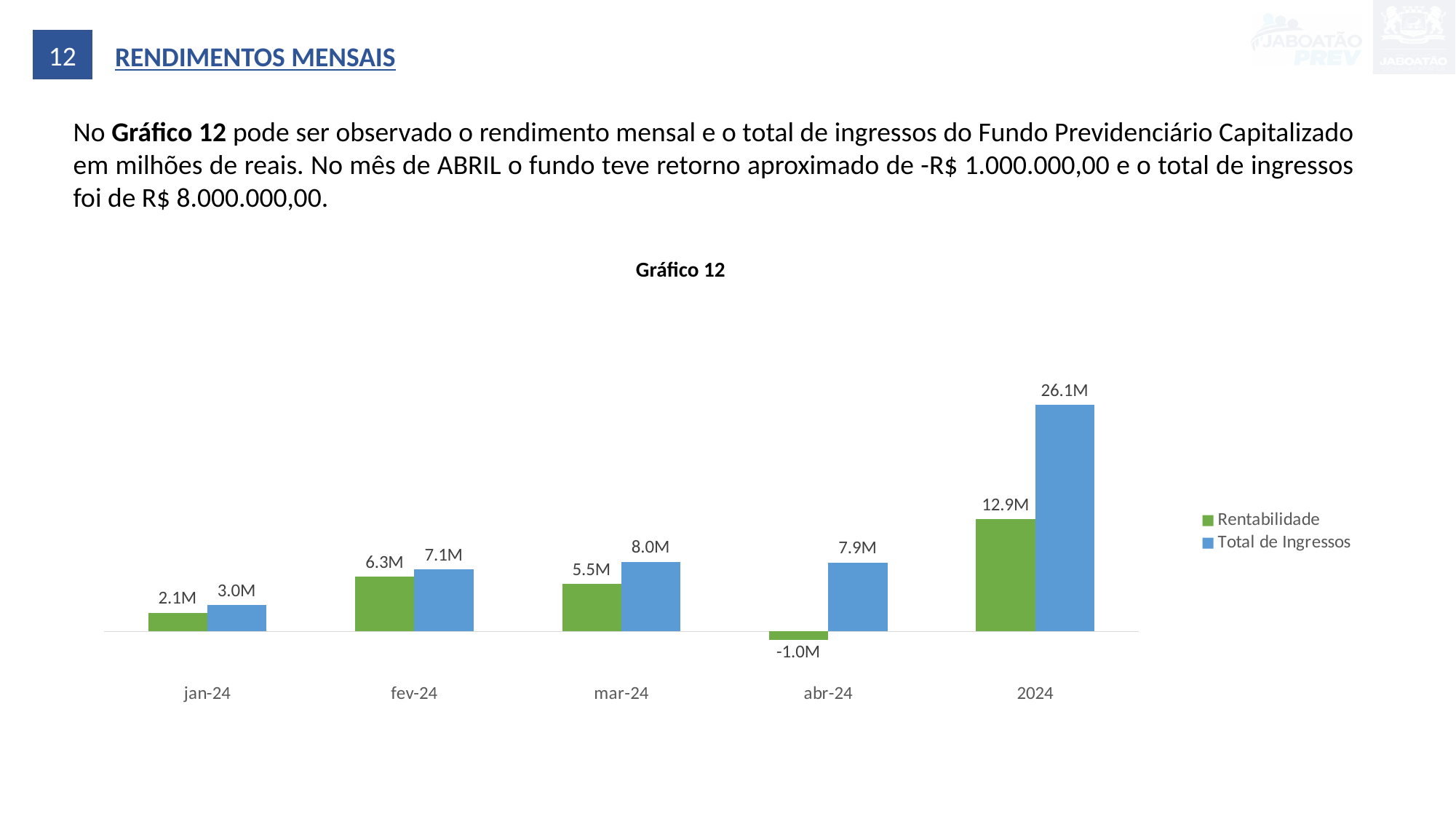
What is the difference between Total de Ingressos and Rentabilidade for 2024? 13.2M Which category has the lowest Rentabilidade value? abr-24 What colour are the Total de Ingressos bars? Blue How many categories are shown on the x axis? 5 What is the Rentabilidade value for fev-24? 6.3M What is the Total de Ingressos value for abr-24? 7.9M What is the title of the chart? Gráfico 12 Which category has the highest Total de Ingressos value? 2024 What kind of chart is shown? Bar chart How many series does the legend list? 2 Which is larger for mar-24, Rentabilidade or Total de Ingressos? Total de Ingressos What is the Rentabilidade value for abr-24? -1.0M